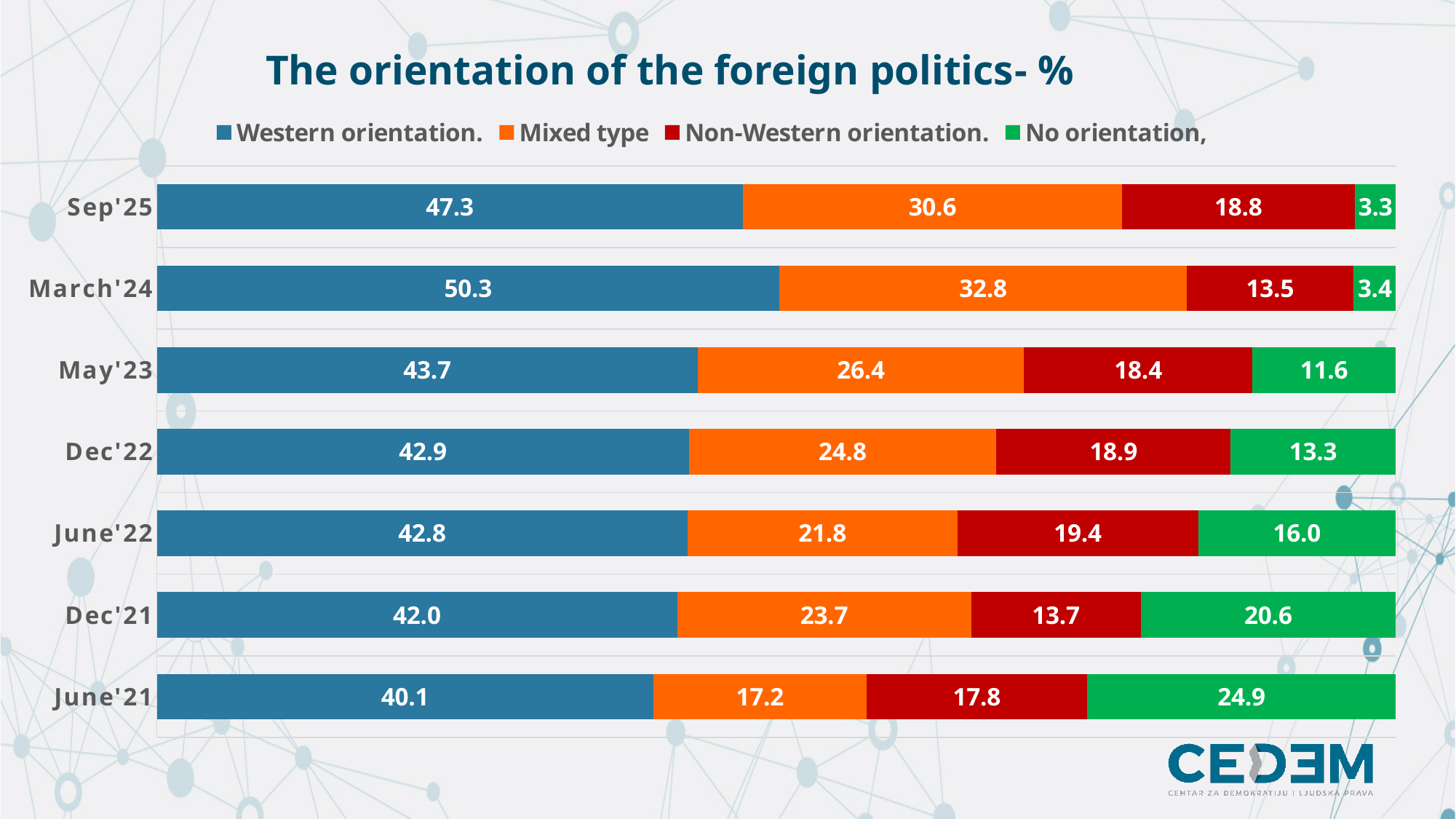
What is the difference between the Mixed type values for Sep'25 and June'21? 13.4 What kind of chart is shown on the slide? Stacked bar chart Does the No orientation value rise or fall from June'21 to Sep'25? Fall What is the value for No orientation in June'21? 24.9 How many periods are shown on the chart? 7 What is the title of the chart? The orientation of the foreign politics- % How many series does the legend list? 4 What is the value for Non-Western orientation in Dec'22? 18.9 Which period has the highest value for Western orientation? March'24 Which is larger: the Non-Western orientation value for June'22 or for Dec'21? June'22 Which period has the lowest value for Mixed type? June'21 What is the value for Western orientation in Sep'25? 47.3